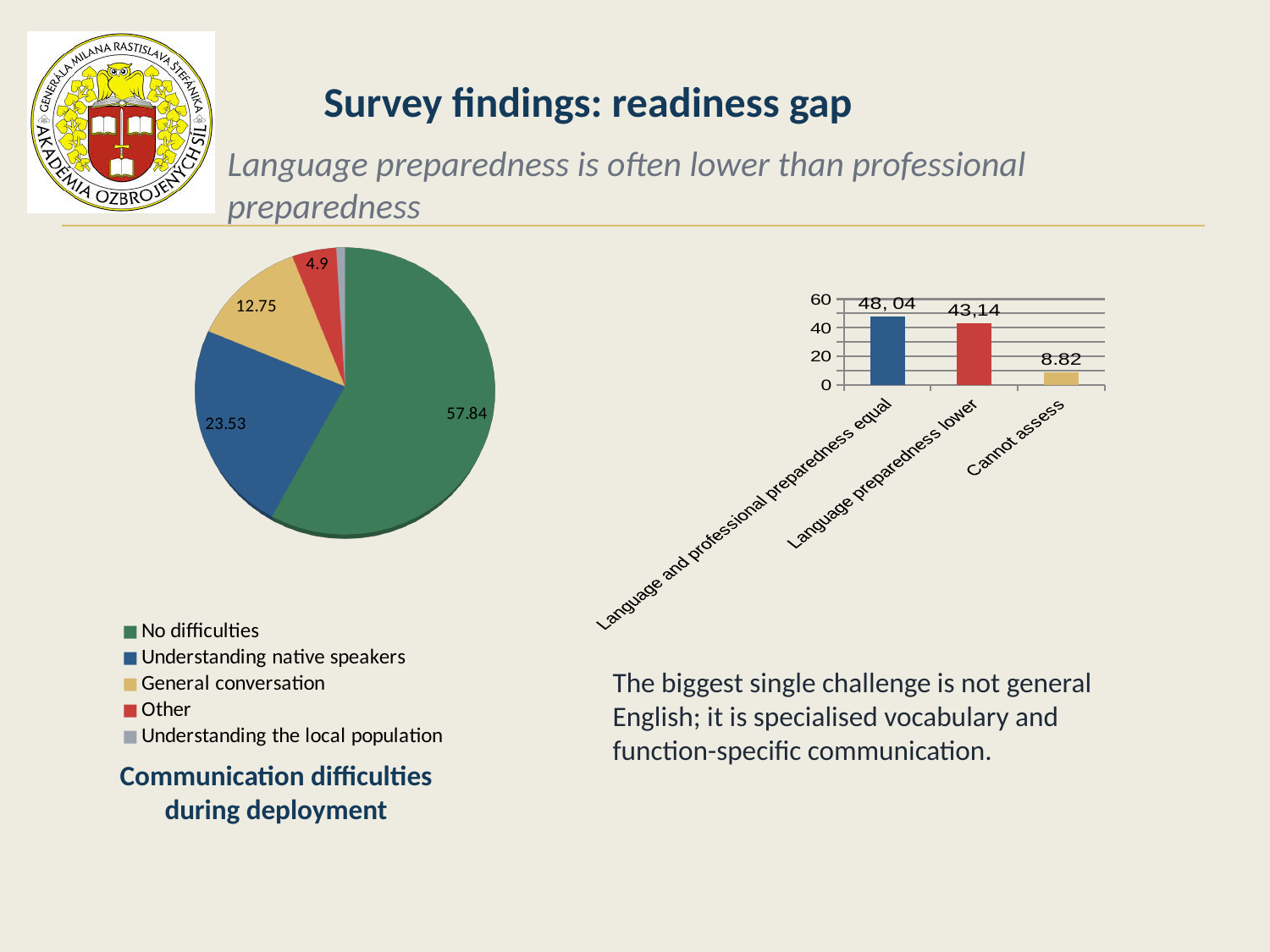
In the bar chart on the right of the slide, what value is shown for 'Language preparedness lower'? 43,14 In the pie chart titled 'Communication difficulties during deployment', which category has the smallest slice? Understanding the local population In the pie chart titled 'Communication difficulties during deployment', which category has the largest slice? No difficulties In the bar chart on the right of the slide, what value is shown for 'Cannot assess'? 8.82 In the pie chart titled 'Communication difficulties during deployment', what value is shown for 'Other'? 4.9 In the pie chart titled 'Communication difficulties during deployment', what is the difference between the values for 'No difficulties' and 'Understanding native speakers'? 34.31 In the pie chart titled 'Communication difficulties during deployment', how many categories does the legend list? 5 In the pie chart titled 'Communication difficulties during deployment', what value is shown for 'No difficulties'? 57.84 In the pie chart titled 'Communication difficulties during deployment', what value is shown for 'Understanding native speakers'? 23.53 What kind of chart is shown on the right of the slide? Bar chart In the bar chart on the right of the slide, which category has the highest bar? Language and professional preparedness equal In the pie chart titled 'Communication difficulties during deployment', what value is shown for 'General conversation'? 12.75